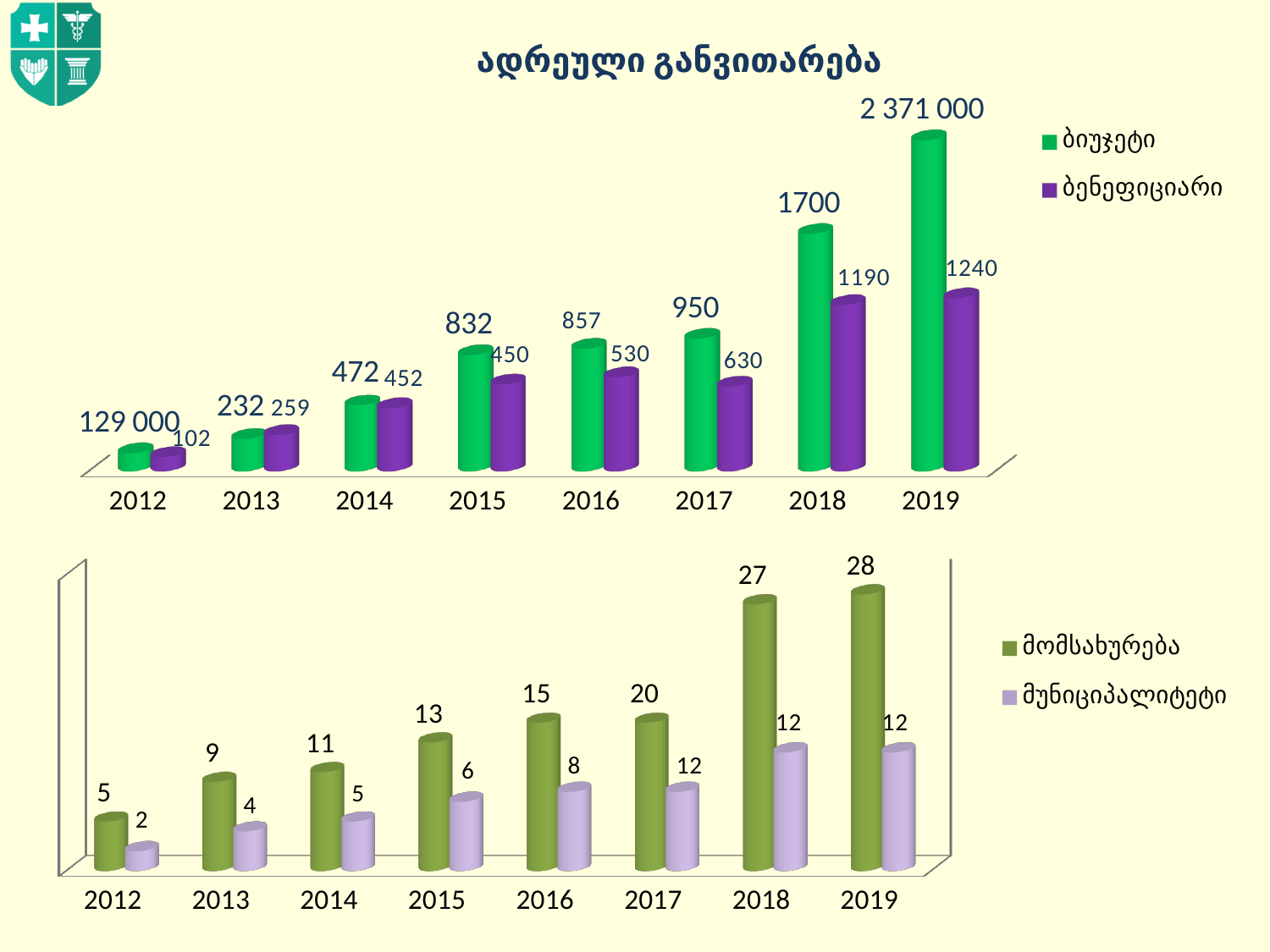
In the bottom chart, what is the value of მუნიციპალიტეტი for 2016? 8 In the top chart, what is the difference between the ბენეფიციარი values for 2018 and 2017? 560 In the bottom chart, what is the difference between the მომსახურება values for 2019 and 2012? 23 In the bottom chart, what is the value of მომსახურება for 2017? 20 In the top chart, how many series does the legend list? 2 In the top chart, which year has the lowest ბენეფიციარი value? 2012 In the top chart, what is the value of ბიუჯეტი for 2019? 2 371 000 In the top chart, what is the value of ბენეფიციარი for 2019? 1240 In the top chart, what is the value of ბიუჯეტი for 2018? 1700 In the bottom chart, which year has the highest მომსახურება value? 2019 In the bottom chart, how many years are shown on the x axis? 8 What kind of chart is the bottom chart? Bar chart